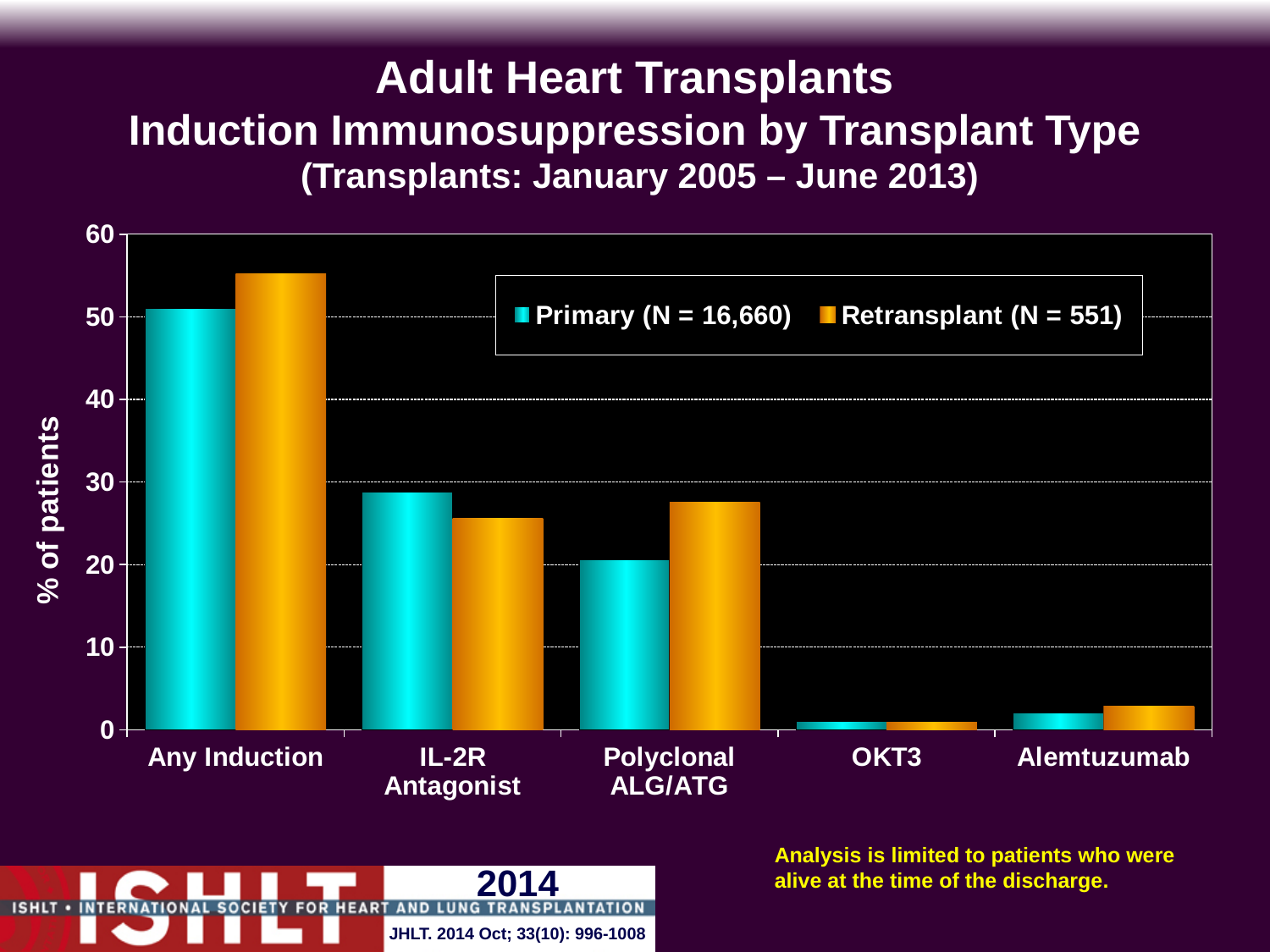
What kind of chart is shown on the slide? bar chart Is the Primary value for Polyclonal ALG/ATG greater or less than 30? less How many induction categories are shown on the x axis? 5 Which category has the lowest value for the Retransplant series? OKT3 What is the label on the y axis? % of patients Is the Retransplant value for Alemtuzumab greater or less than 10? less For Any Induction, which series has the larger value, Primary or Retransplant? Retransplant How many series does the legend list? 2 For Polyclonal ALG/ATG, which series has the larger value, Primary or Retransplant? Retransplant Is the Retransplant value for Any Induction greater or less than 50? greater For IL-2R Antagonist, which series has the larger value, Primary or Retransplant? Primary Which category has the highest value for the Primary series? Any Induction